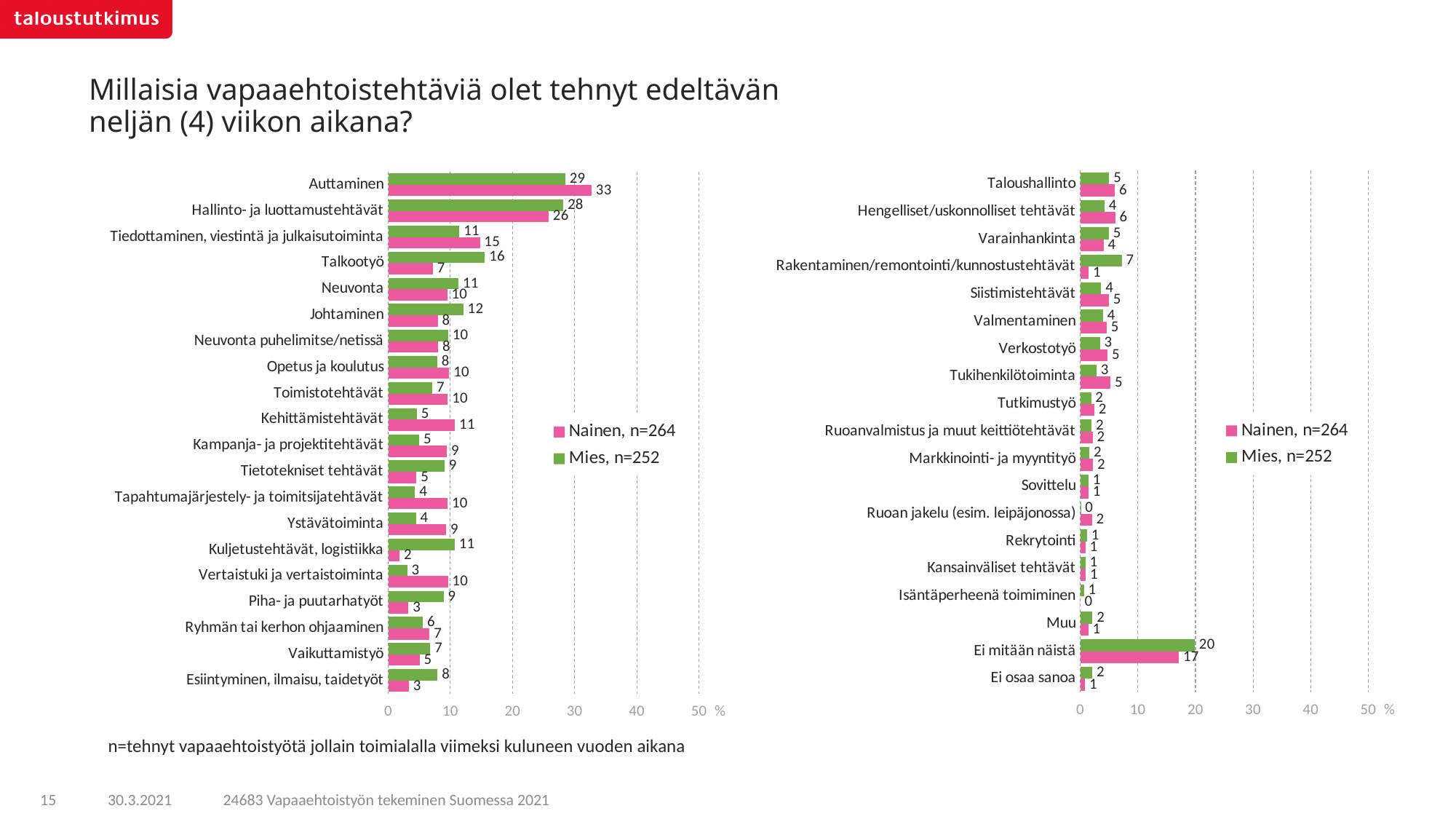
In the left chart, what is the difference between the Nainen and Mies values for Talkootyö? 9 In the left chart, which category has the lowest value for Nainen? Kuljetustehtävät, logistiikka In the left chart, is the Nainen value for Auttaminen greater or less than 30? greater In the left chart, what is the value for Mies for Talkootyö? 16 What type of chart is the left chart? Bar chart How many categories are shown in the right chart? 19 In the right chart, what is the difference between the Mies and Nainen values for Ei mitään näistä? 3 In the left chart, which is larger for Kuljetustehtävät, logistiikka: the Nainen value or the Mies value? Mies In the right chart, what is the value for Mies for Rakentaminen/remontointi/kunnostustehtävät? 7 In the right chart, which category has the highest value for Mies? Ei mitään näistä How many series does the legend of the left chart list? 2 In the left chart, what is the value for Nainen for Auttaminen? 33